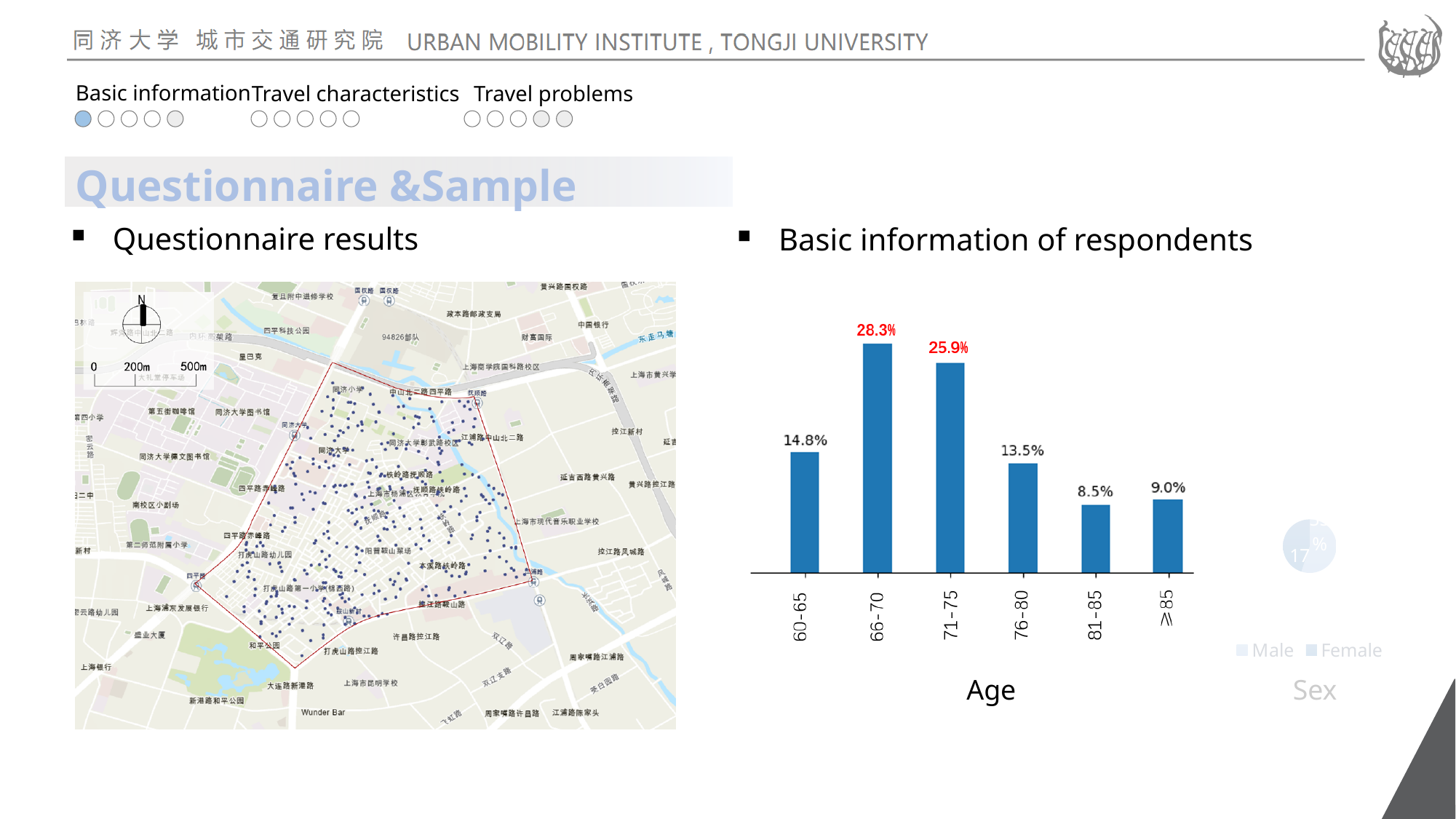
In the Age chart, what is the difference between the 60-65 and 76-80 age groups? 1.3% In the Age chart, what is the difference between the 66-70 and 71-75 age groups? 2.4% How many age groups are shown in the Age chart? 6 In the Age chart, what is the value for the 81-85 age group? 8.5% In the Age chart, which age group has the highest share of respondents? 66-70 In the Age chart, what is the value for the ≥85 age group? 9.0% In the Age chart, which two bars have their data labels shown in red? 66-70 and 71-75 In the Age chart, which age group has the lowest share of respondents? 81-85 What type of chart is the Age chart? Bar chart In the Age chart, what percentage of respondents are aged 66-70? 28.3% In the Age chart, which is larger, the value for 60-65 or the value for 76-80? 60-65 In the Age chart, what percentage of respondents are aged 60-65? 14.8%